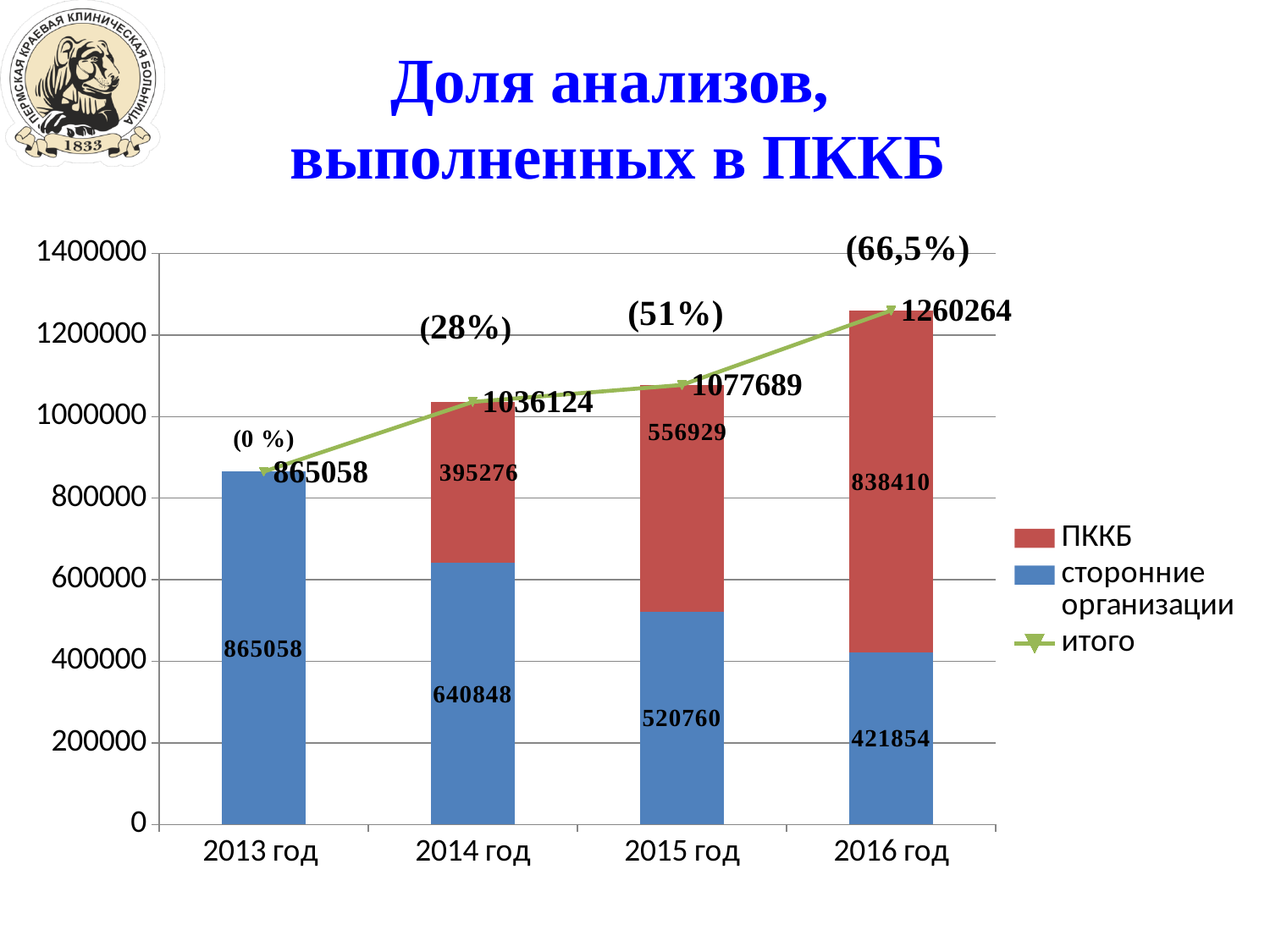
In which year is the ПККБ value highest? 2016 год Which is larger in 2015 год: ПККБ or сторонние организации? ПККБ What kind of chart is shown on the slide? Stacked bar chart with a line What is the value for сторонние организации in 2014 год? 640848 What is the value for ПККБ in 2015 год? 556929 How many years are shown on the x axis? 4 Does the итого line rise or fall from 2013 год to 2016 год? Rises In which year is the сторонние организации value lowest? 2016 год What is the итого value for 2016 год? 1260264 What is the difference between the итого values for 2016 год and 2015 год? 182575 What percentage is shown above the bar for 2014 год? 28% How many series does the legend list? 3